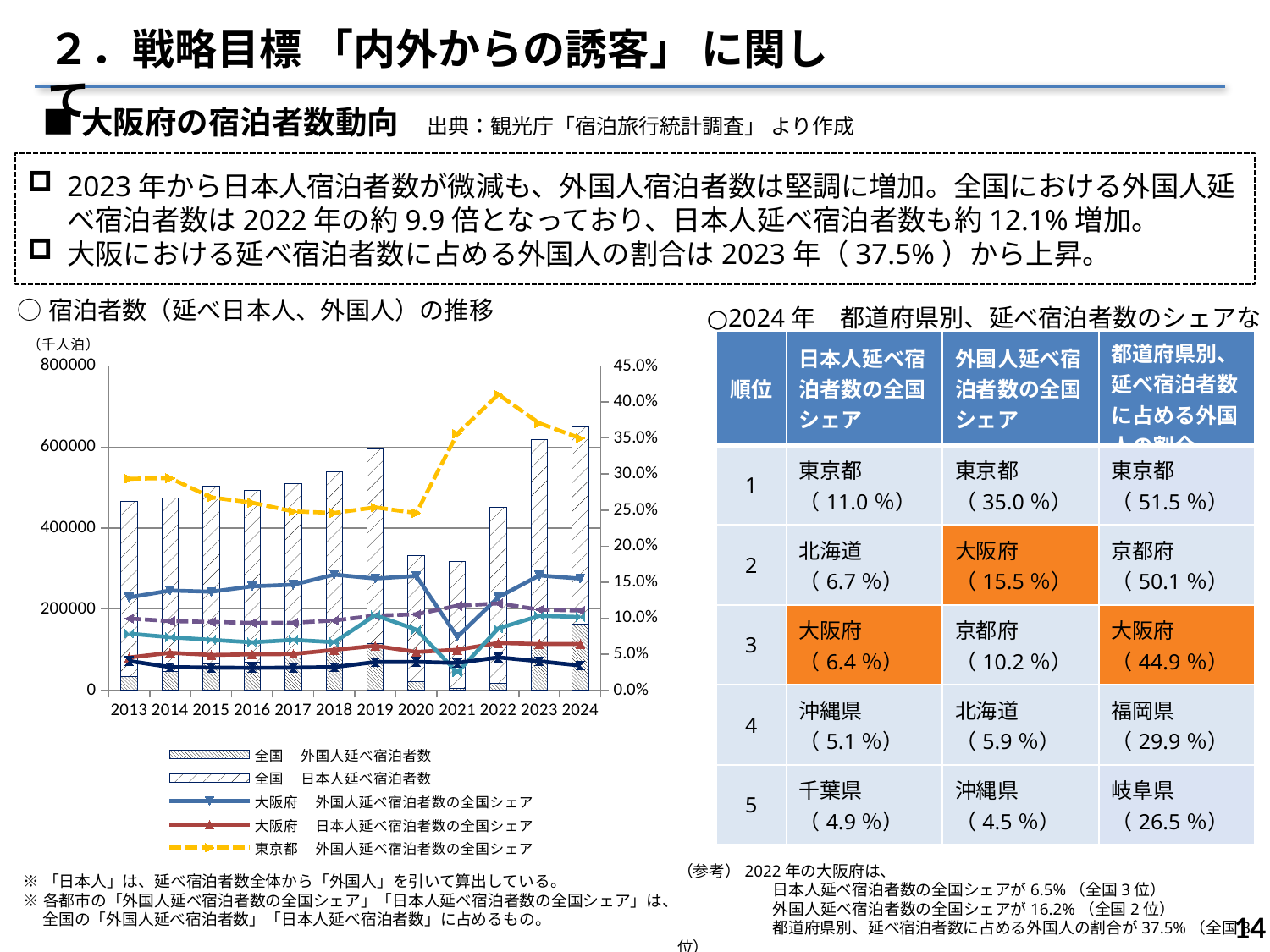
What is the title of the chart? 宿泊者数（延べ日本人、外国人）の推移 Is the value for 全国 外国人延べ宿泊者数 in 2021 greater or less than 200000? less What unit is shown for the left axis of the chart? 千人泊 Is the value for 全国 日本人延べ宿泊者数 in 2021 greater or less than 400000? less What kind of chart is shown on the slide? A combined bar and line chart Is the value for 大阪府 外国人延べ宿泊者数の全国シェア in 2021 greater or less than 10.0%? less Which is larger in 2024: 東京都 外国人延べ宿泊者数の全国シェア or 大阪府 外国人延べ宿泊者数の全国シェア? 東京都 外国人延べ宿泊者数の全国シェア Did 東京都 外国人延べ宿泊者数の全国シェア rise or fall from 2020 to 2022? rise Did 全国 日本人延べ宿泊者数 rise or fall from 2019 to 2020? fall How many years are shown on the x axis of the chart? 12